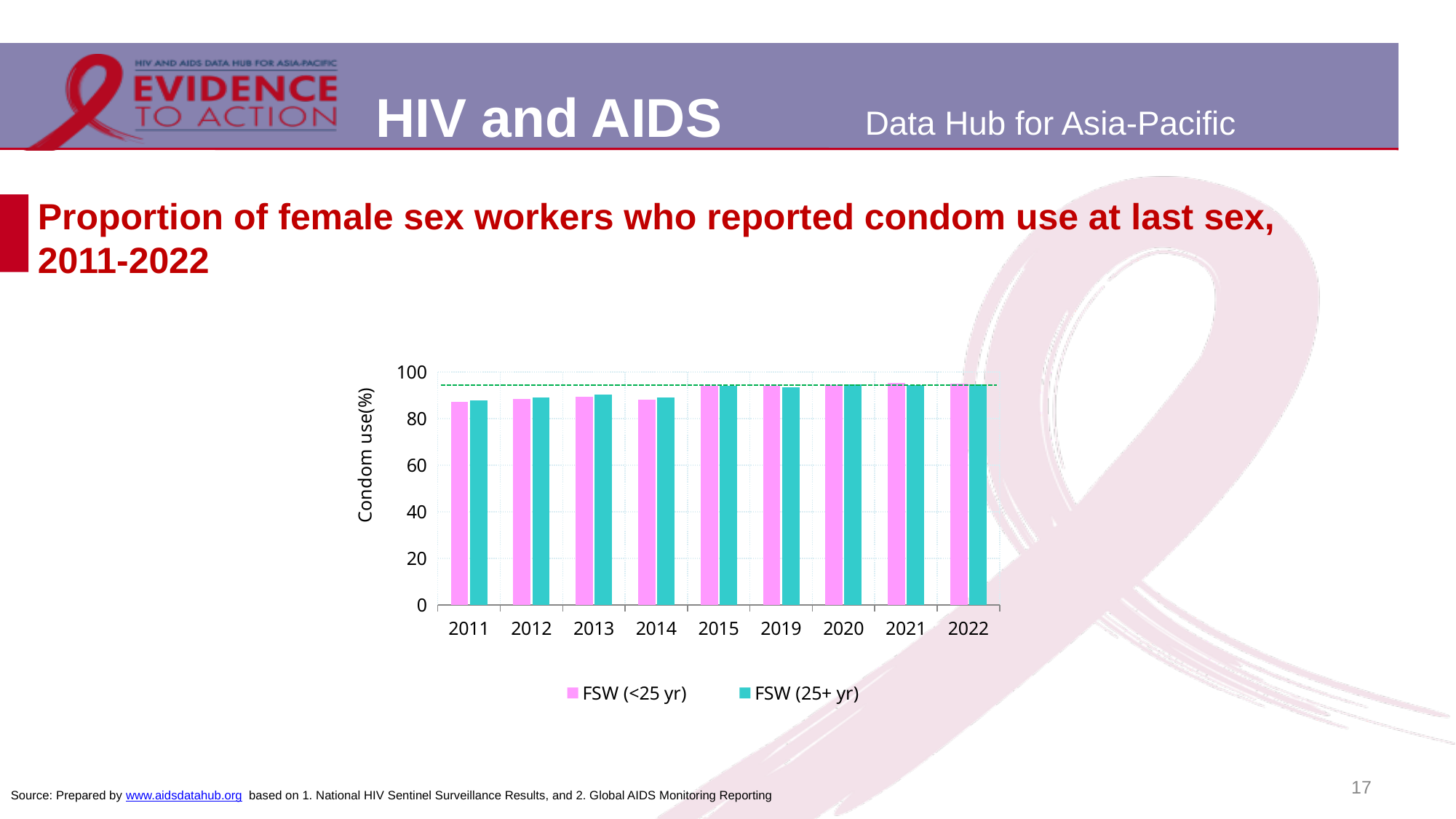
Is the value for FSW (25+ yr) in 2014 greater or less than 100? less What are the two series named in the legend? FSW (<25 yr) and FSW (25+ yr) Is the value for FSW (25+ yr) in 2022 greater or less than 60? greater Do the values for FSW (25+ yr) generally rise or fall from 2011 to 2022? rise Is the value for FSW (<25 yr) in 2011 greater or less than 80? greater Which is larger for FSW (25+ yr): the value in 2012 or the value in 2020? 2020 Which year is the first shown on the x axis of the chart? 2011 How many years are shown on the x axis of the chart? 9 How many series does the chart's legend list? 2 What is the label on the vertical axis of the chart? Condom use(%) What kind of chart is shown on the slide? bar chart Which is larger for FSW (<25 yr): the value in 2011 or the value in 2021? 2021